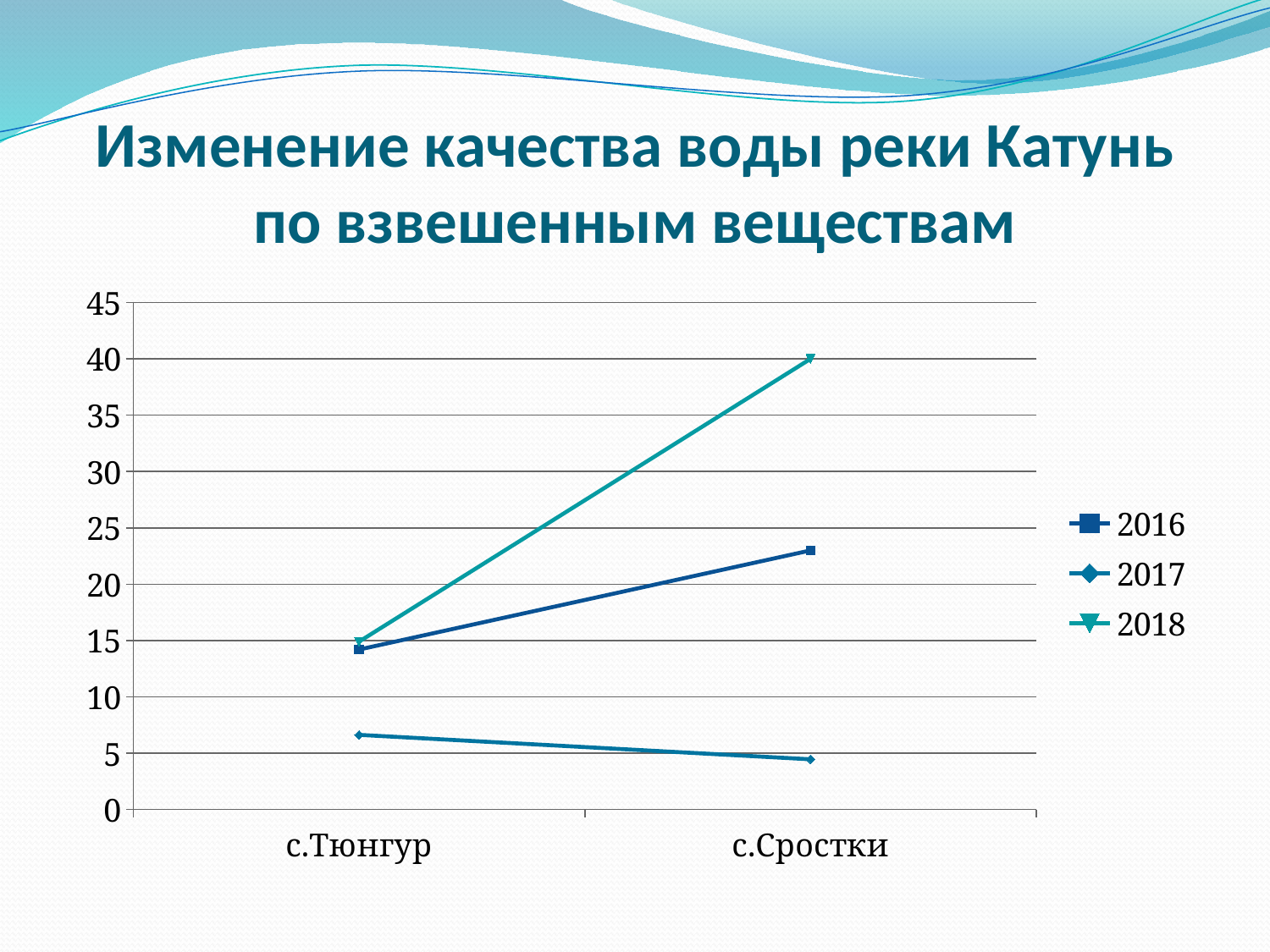
How many series does the legend list? 3 Is the value for 2017 at с.Сростки greater or less than 10? less Is the value for 2018 at с.Сростки greater or less than 35? greater Which series has the lowest value at с.Тюнгур? 2017 What kind of chart is shown on the slide? line chart Is the value for 2016 at с.Сростки greater or less than 20? greater Which is larger at с.Сростки: the 2016 value or the 2017 value? 2016 Does the 2018 series rise or fall from с.Тюнгур to с.Сростки? rise How many categories are shown on the x axis? 2 What is the title of the chart on the slide? Изменение качества воды реки Катунь по взвешенным веществам Which series has the highest value at с.Сростки? 2018 Does the 2017 series rise or fall from с.Тюнгур to с.Сростки? fall